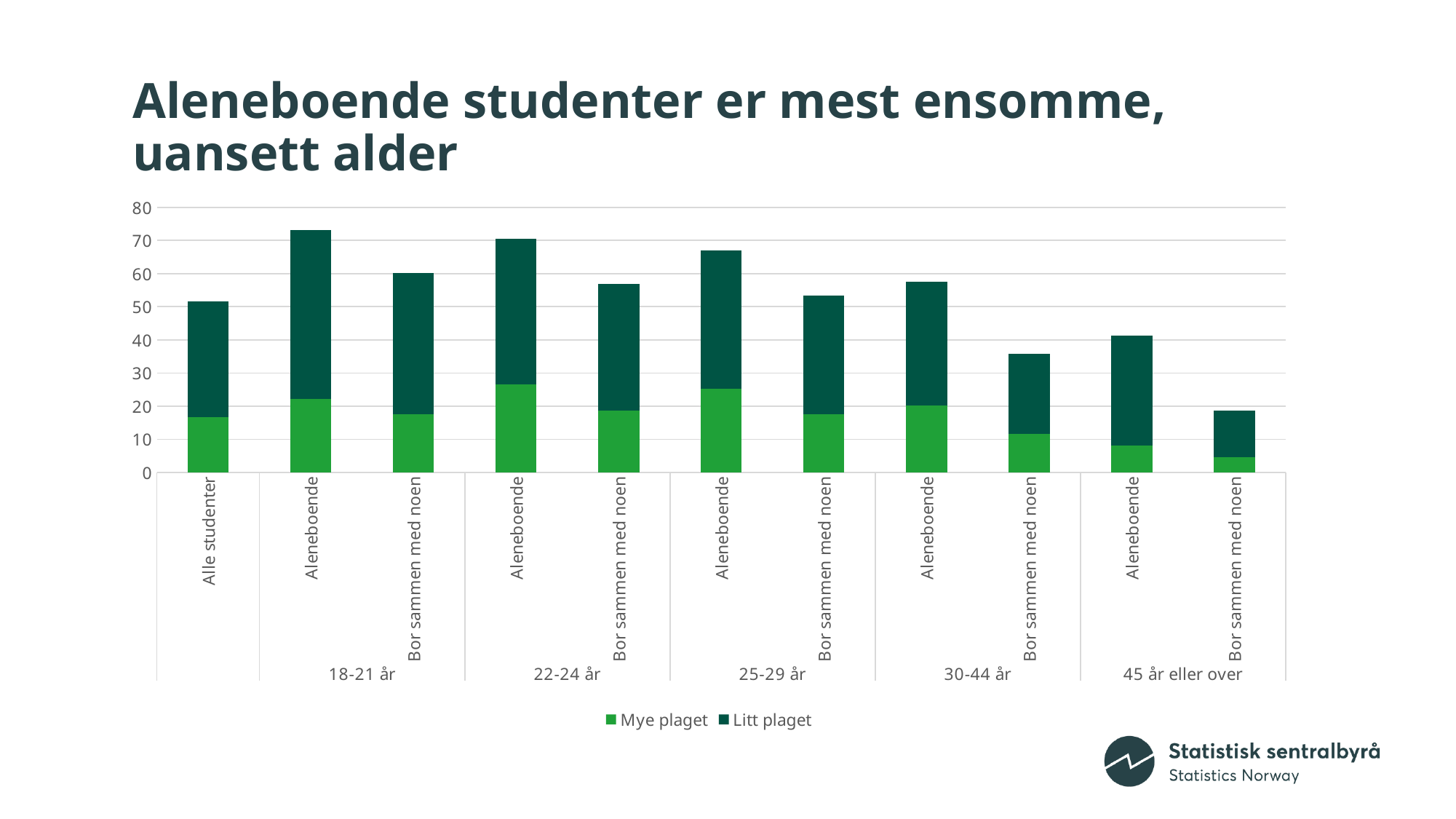
In the 25-29 år group, which has the larger total: Aleneboende or Bor sammen med noen? Aleneboende Is the total for Bor sammen med noen in the 45 år eller over group greater or less than 20? less What kind of chart is shown on the slide? Stacked bar chart How many series does the legend list? 2 Which bar has the lowest total? Bor sammen med noen, 45 år eller over Do the totals for Aleneboende rise or fall as the age groups go from 18-21 år to 45 år eller over? fall How many bars are plotted in the chart? 11 Is the total for Bor sammen med noen in the 30-44 år group greater or less than 40? less What are the two series named in the legend? Mye plaget and Litt plaget Which bar has the highest total? Aleneboende, 18-21 år Is the total for Aleneboende in the 18-21 år group greater or less than 70? greater